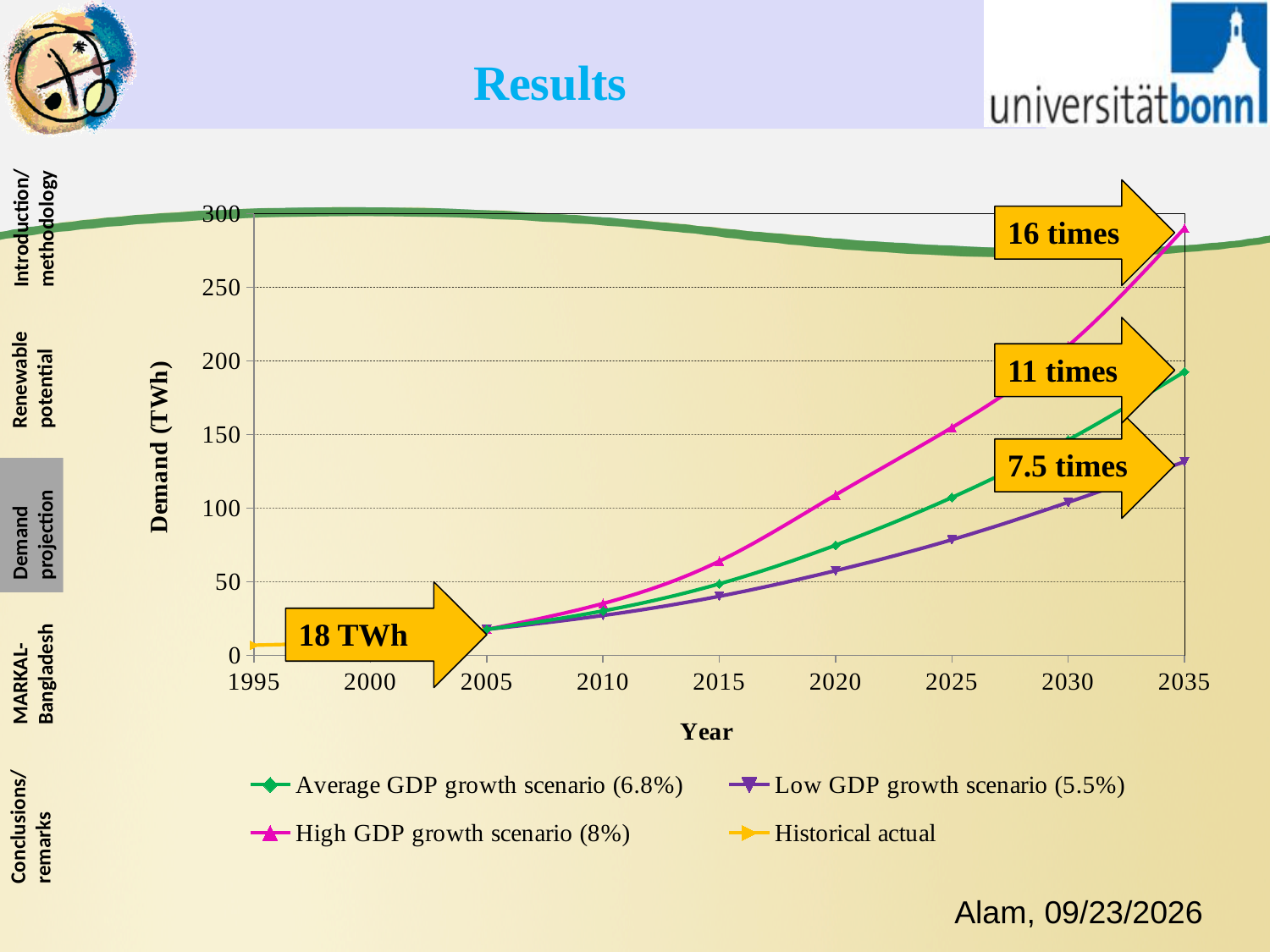
What demand value does the arrow annotation give for 2005? 18 TWh How many series does the chart legend list? 4 Is the value for the Low GDP growth scenario (5.5%) in 2035 greater or less than 150? less What is the title of the horizontal axis? Year Is the value for the Average GDP growth scenario (6.8%) in 2035 greater or less than 150? greater What type of chart is shown on the slide? line chart Is the value for the High GDP growth scenario (8%) in 2035 greater or less than 250? greater Which scenario has the highest demand in 2035? High GDP growth scenario (8%) Does the Average GDP growth scenario (6.8%) rise or fall from 2005 to 2035? rise In 2035, which is larger: the High GDP growth scenario (8%) or the Low GDP growth scenario (5.5%)? High GDP growth scenario (8%) What is the title of the vertical axis? Demand (TWh)